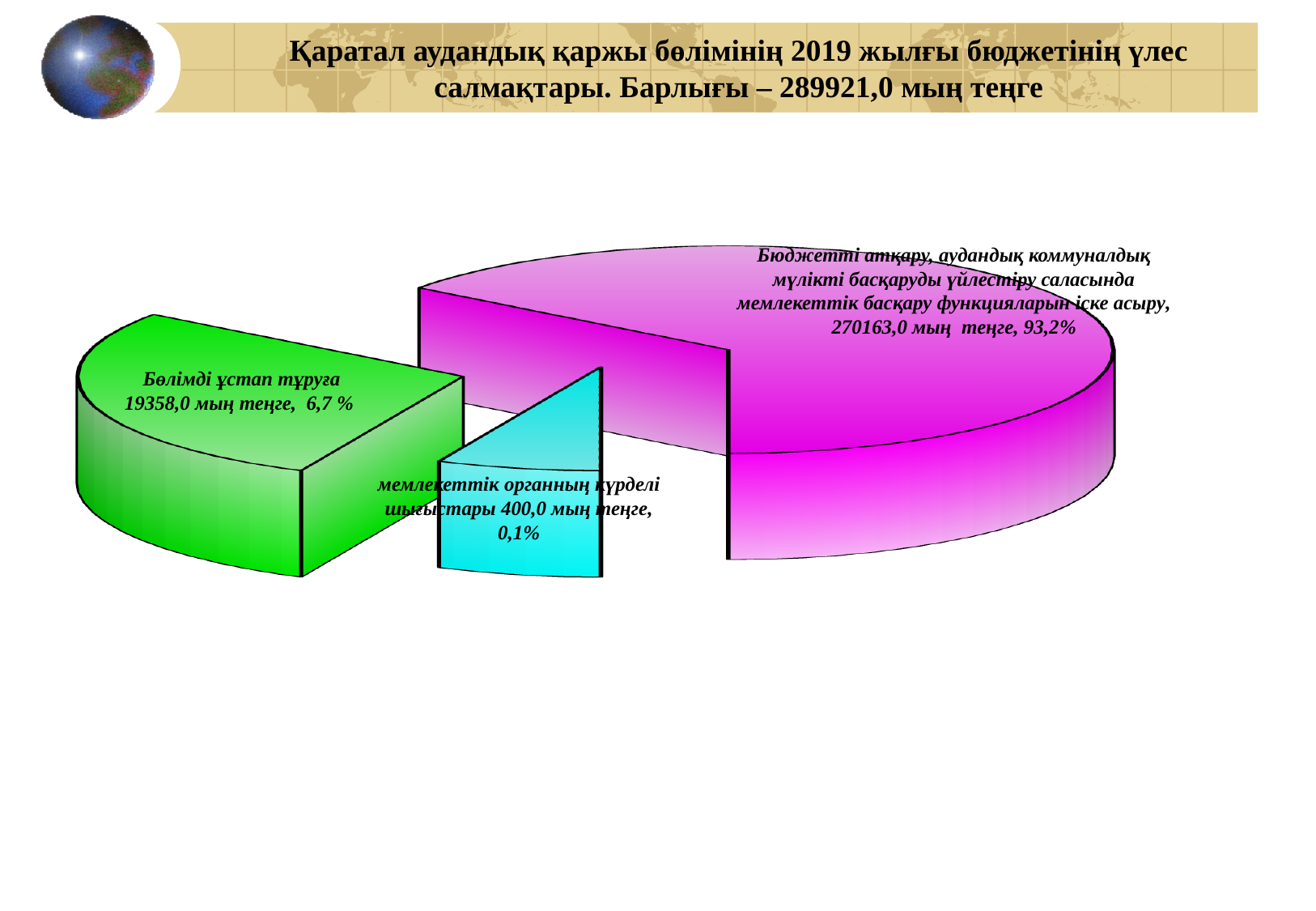
What share of the pie does "Бөлімді ұстап тұруға" represent? 6,7 % How many slices does the pie chart have? 3 What kind of chart is shown on the slide? pie chart What colour is the slice for "Бөлімді ұстап тұруға"? green Which slice is the largest? Бюджетті атқару, аудандық коммуналдық мүлікті басқаруды үйлестіру саласында мемлекеттік басқару функцияларын іске асыру What is the difference between the values for "Бөлімді ұстап тұруға" and "мемлекеттік органның күрделі шығыстары"? 18958,0 мың теңге What share of the pie does "мемлекеттік органның күрделі шығыстары" represent? 0,1% Which is larger: "Бөлімді ұстап тұруға" or "мемлекеттік органның күрделі шығыстары"? Бөлімді ұстап тұруға What is the value for "Бюджетті атқару, аудандық коммуналдық мүлікті басқаруды үйлестіру саласында мемлекеттік басқару функцияларын іске асыру"? 270163,0 мың теңге What is the value for "мемлекеттік органның күрделі шығыстары"? 400,0 мың теңге What is the value for "Бөлімді ұстап тұруға"? 19358,0 мың теңге Which slice is the smallest? мемлекеттік органның күрделі шығыстары